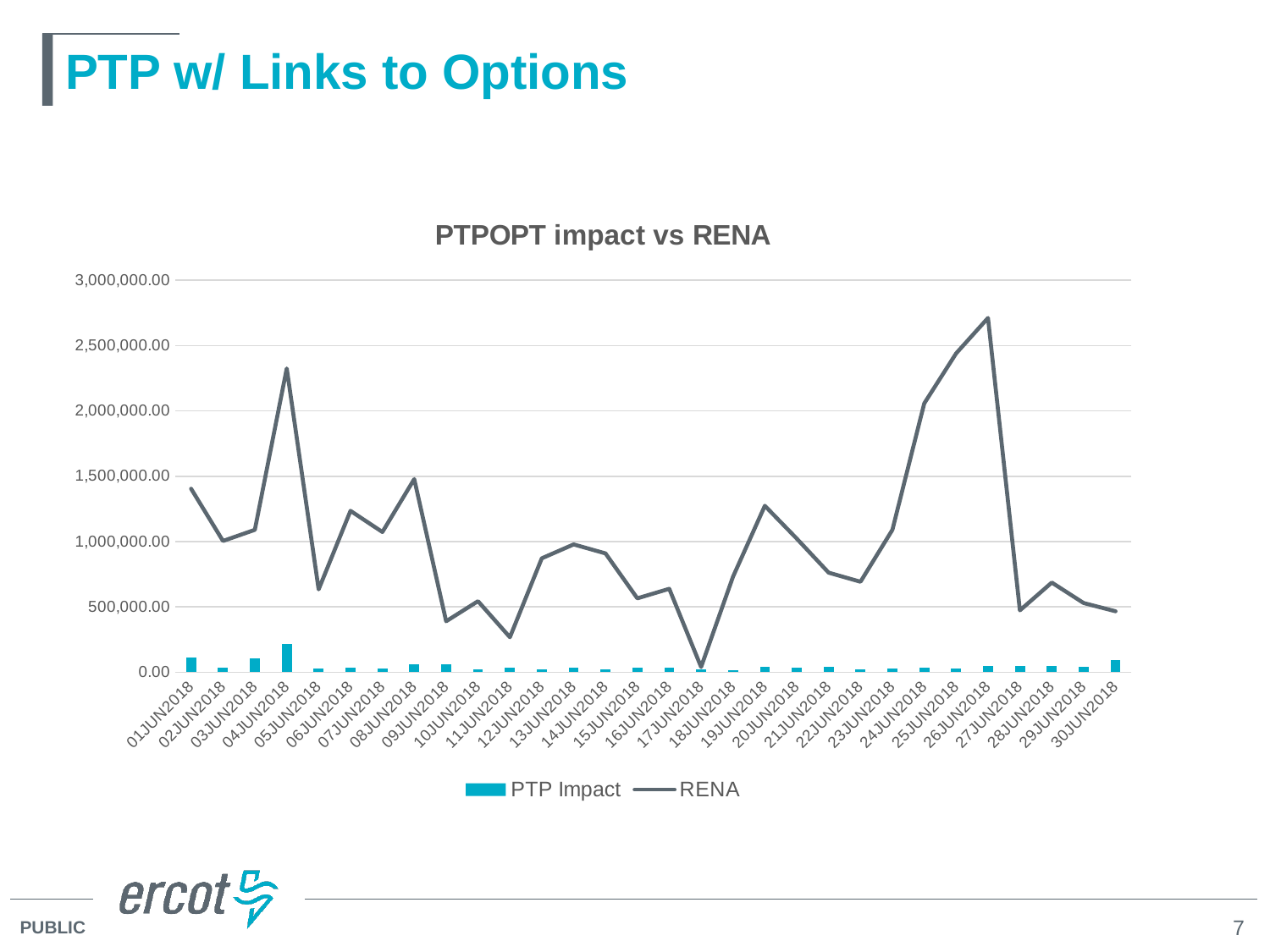
How many series does the legend list? 2 On which date is the PTP Impact bar the tallest? 04JUN2018 Does the RENA series rise or fall between 26JUN2018 and 27JUN2018? fall Is the RENA value for 26JUN2018 greater or less than 2,500,000.00? greater On which date does the RENA series reach its highest value? 26JUN2018 How many dates are shown on the x axis? 30 On which date does the RENA series reach its lowest value? 17JUN2018 What kind of chart is this? A combined bar and line chart What is the title of the chart? PTPOPT impact vs RENA What are the names of the two series in the legend? PTP Impact and RENA Which has the larger RENA value, 04JUN2018 or 26JUN2018? 26JUN2018 Is the RENA value for 17JUN2018 greater or less than 500,000.00? less